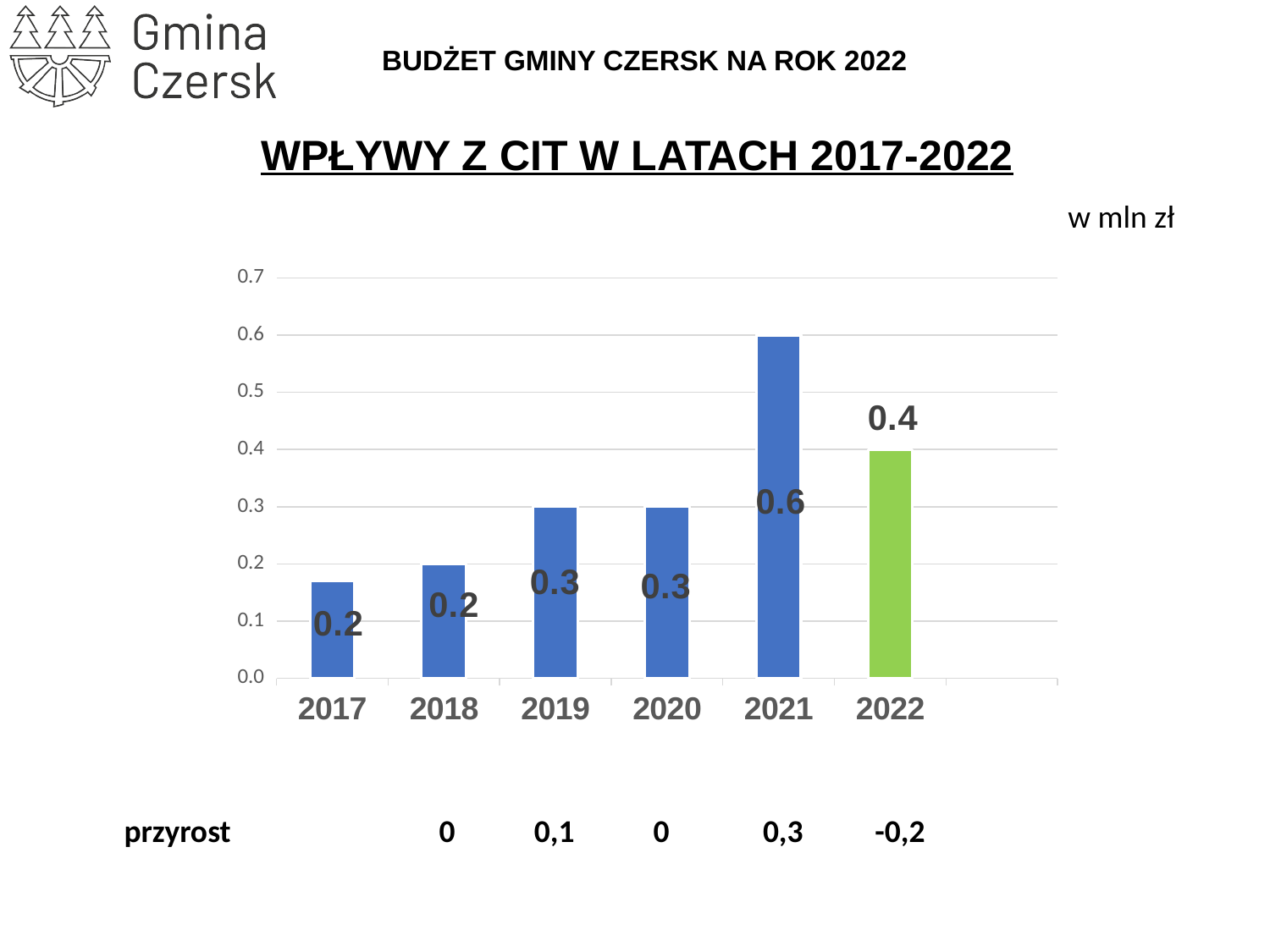
What is the difference between the values for 2021 and 2017? 0.4 What is the value for 2019? 0.3 Is the value for 2022 greater or less than 0.5? less What is the value for 2021? 0.6 How many years are shown on the x axis? 6 Is the value for 2021 greater or less than 0.5? greater What is the title of the chart? WPŁYWY Z CIT W LATACH 2017-2022 What is the difference between the values for 2021 and 2022? 0.2 Which year has the highest value? 2021 Which is larger, the value for 2021 or the value for 2020? 2021 What kind of chart is shown? bar chart What is the value for 2022? 0.4